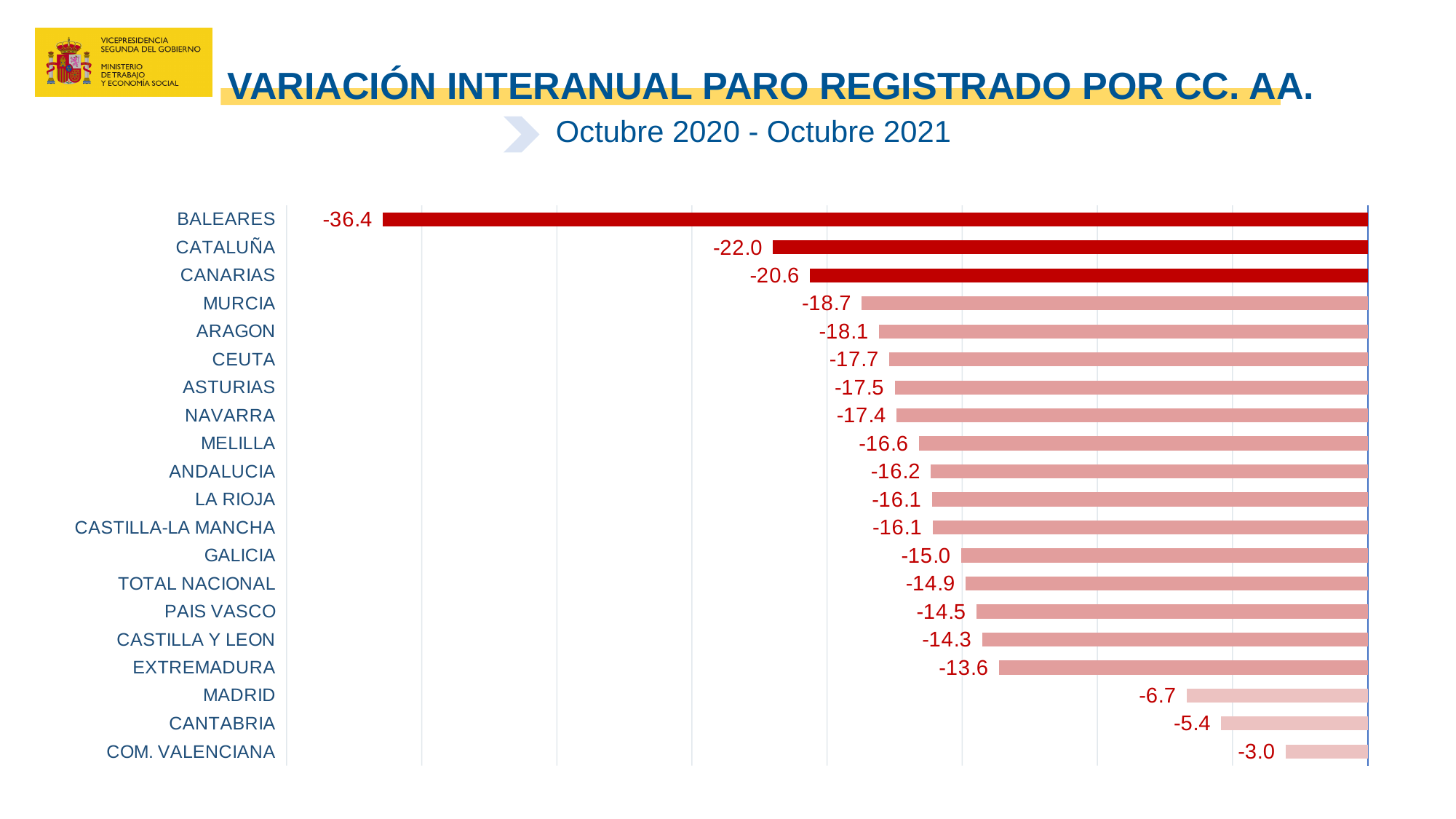
What is the value for CASTILLA-LA MANCHA? -16.1 Which category has the lowest (most negative) value? BALEARES How many categories are shown in the chart? 20 What is the value for BALEARES? -36.4 What is the difference between the values for MADRID and CANTABRIA? 1.3 What is the value for TOTAL NACIONAL? -14.9 Which has a more negative value, CANARIAS or MURCIA? CANARIAS What is the value for MADRID? -6.7 What period does the chart subtitle cover? Octubre 2020 - Octubre 2021 What is the difference between the values for BALEARES and CATALUÑA? 14.4 Which category has the highest (least negative) value? COM. VALENCIANA What kind of chart is shown on the slide? Bar chart